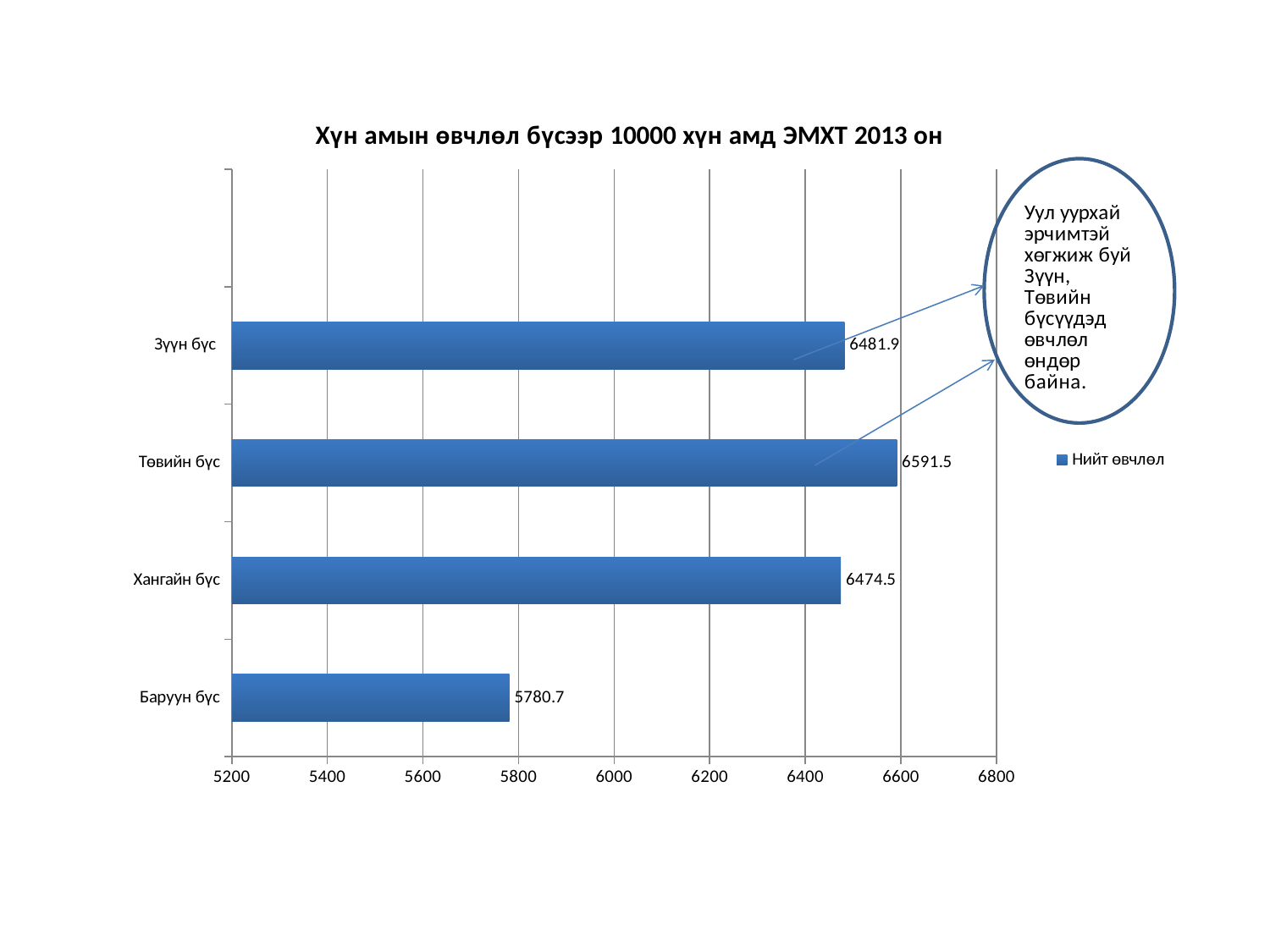
What kind of chart is shown on the slide? Bar chart What is the value for Зүүн бүс? 6481.9 What is the value for Хангайн бүс? 6474.5 What is the value for Баруун бүс? 5780.7 Which region has the highest value? Төвийн бүс What is the value for Төвийн бүс? 6591.5 What is the difference between the values for Төвийн бүс and Зүүн бүс? 109.6 Which is larger, the value for Хангайн бүс or the value for Баруун бүс? Хангайн бүс What is the difference between the values for Төвийн бүс and Баруун бүс? 810.8 Which region has the lowest value? Баруун бүс Is the value for Баруун бүс greater or less than 5800? less How many regions are shown in the chart? 4